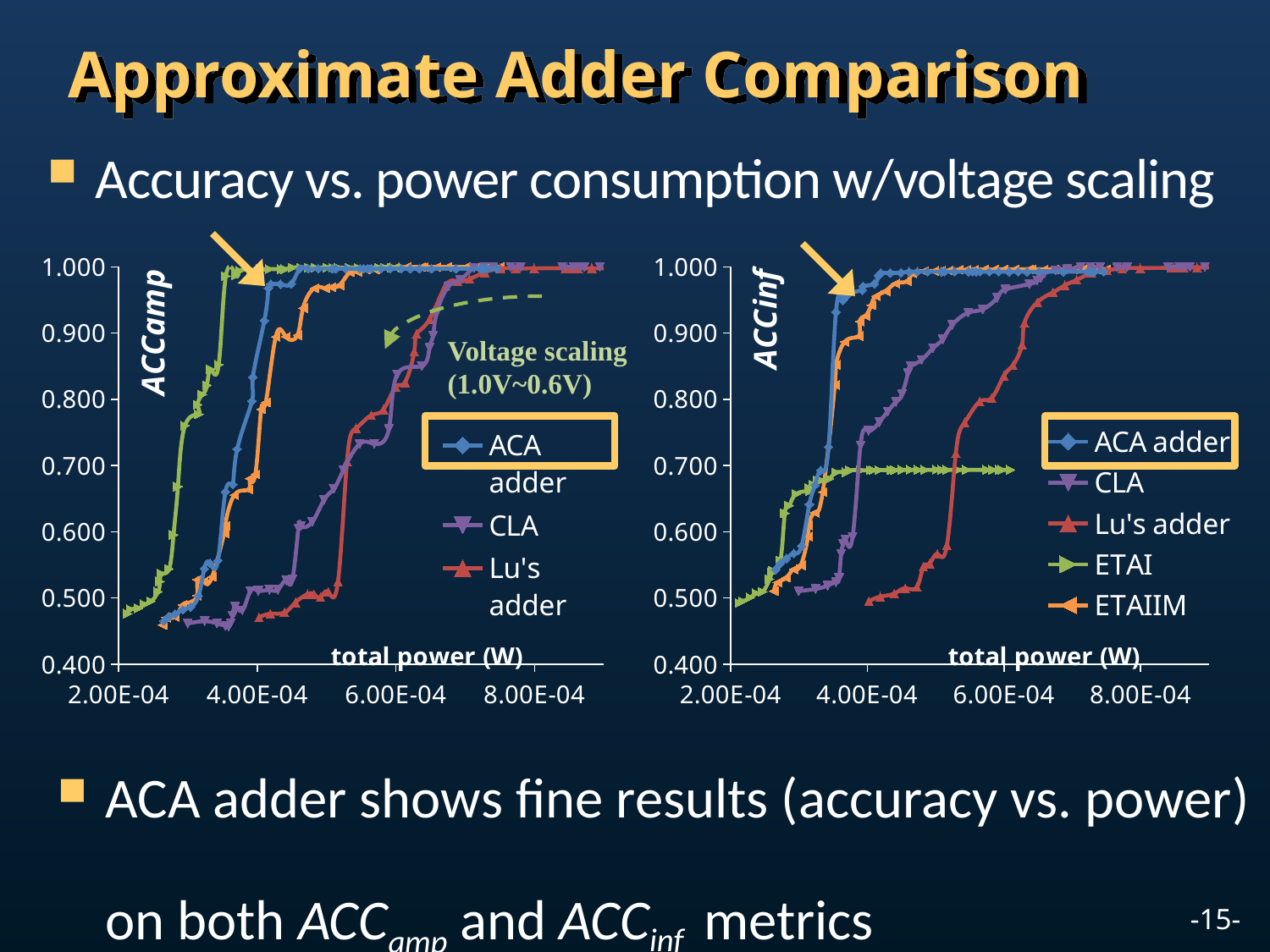
In the right chart (ACCinf), is the highest value reached by ETAI greater or less than 0.800? less In the left chart (ACCamp), at 4.00E-04 W, which series has the higher value, ACA adder or CLA? ACA adder What is the x-axis label of the left chart (ACCamp)? total power (W) In the right chart (ACCinf), is the value for ACA adder at 4.00E-04 W greater or less than 0.900? greater In the right chart (ACCinf), which series reaches 1.000 at the lowest total power? ACA adder What kind of chart is the left chart (ACCamp)? line chart What is the y-axis label of the right chart? ACCinf In the right chart (ACCinf), at 5.00E-04 W, which series has the higher value, CLA or Lu's adder? CLA In the left chart (ACCamp), is the value for Lu's adder at 5.00E-04 W greater or less than 0.600? less How many series does the legend of the right chart (ACCinf) list? 5 In the right chart (ACCinf), do the ACA adder values rise or fall as total power increases? rise What is the lowest value shown on the y-axis of the left chart (ACCamp)? 0.400